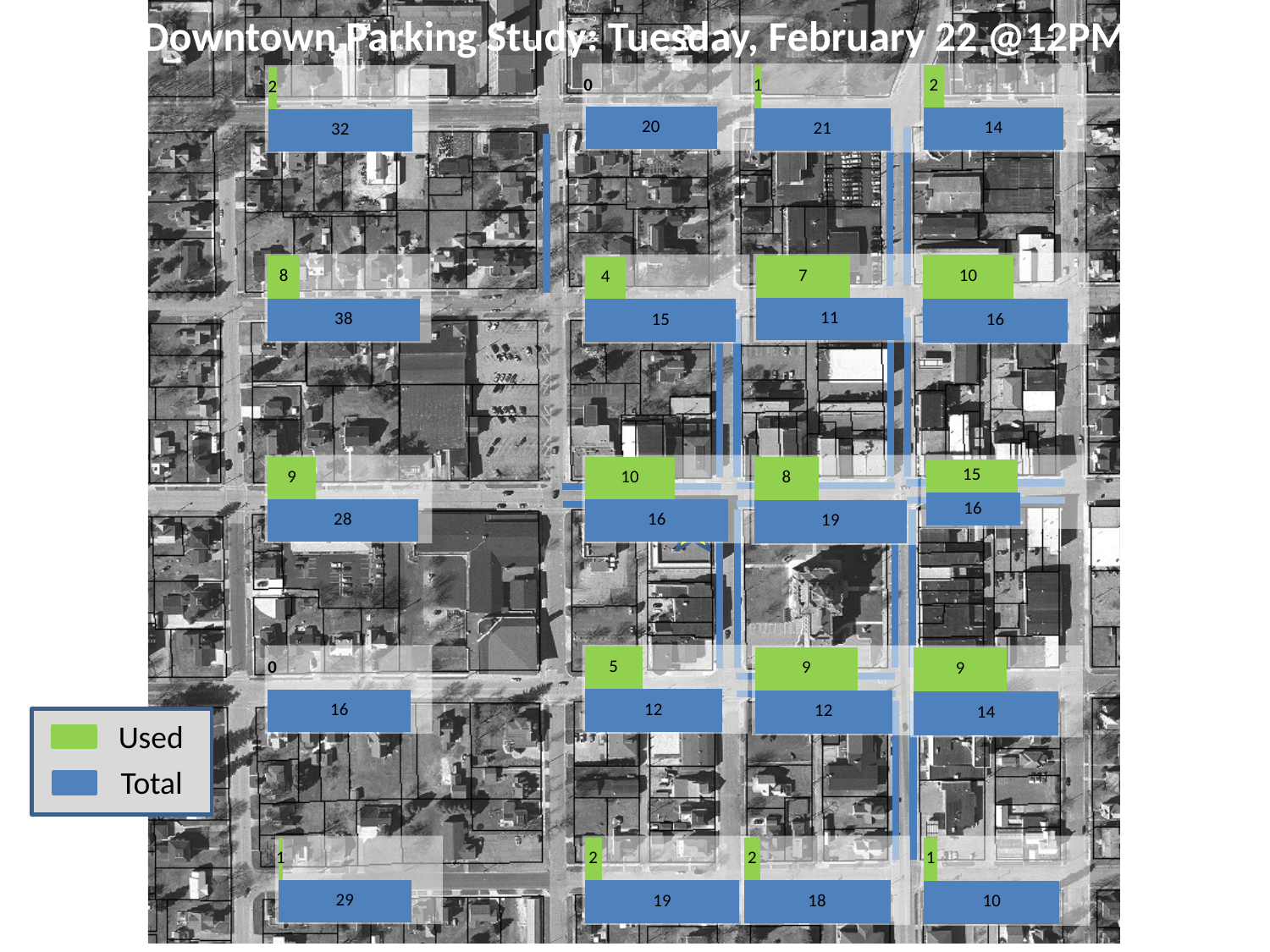
What is the title of the chart on the slide? Downtown Parking Study: Tuesday, February 22 @12PM What is the Total value for the block in the bottom-right corner of the map? 10 How many series does the legend list? 2 What is the Used value for the block in the top-left corner of the map? 2 What is the Total value for the block in the top-left corner of the map? 32 What is the difference between the Total and Used values for the block in the top-left corner of the map? 30 What is the highest Used value shown on the map? 15 Which is larger, the Total value for the top-left block or the Total value for the bottom-right block? Top-left block How many blocks have Used and Total bars plotted on the map? 20 What is the lowest Total value shown on the map? 10 Which colour represents the Used series in the legend? Green What is the highest Total value shown on the map? 38